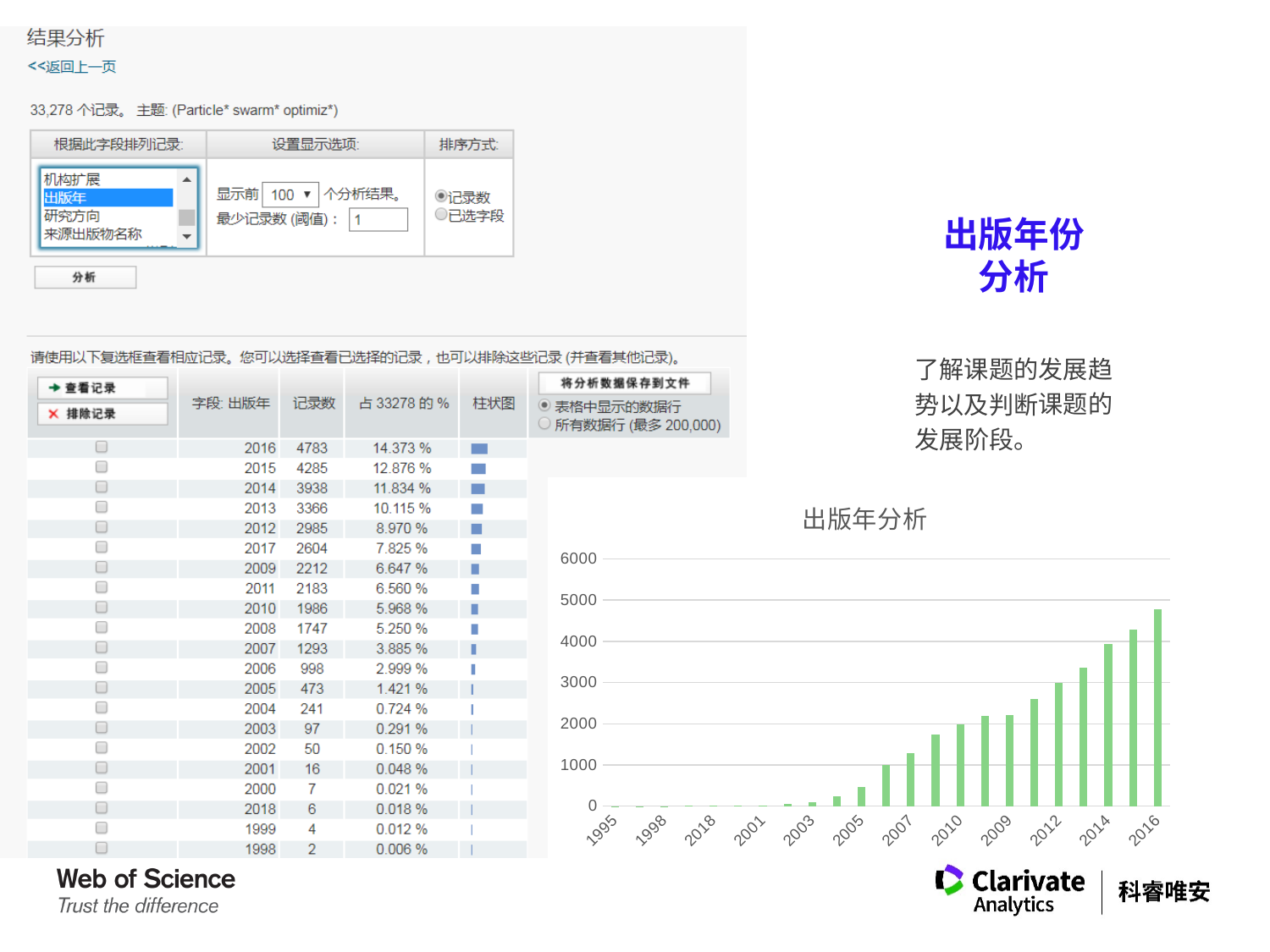
In the 出版年分析 chart, is the value for 2016 greater or less than 4000? greater In the 出版年分析 chart, is the value for 2005 greater or less than 1000? less In the 出版年分析 chart, is the value for 2014 greater or less than 3000? greater In the 出版年分析 chart, which year has the tallest bar? 2016 What kind of chart is shown under the title 出版年分析? bar chart In the 出版年分析 chart, which bar is taller, 2007 or 2005? 2007 In the 出版年分析 chart, which bar is taller, 2014 or 2012? 2014 What colour are the bars in the 出版年分析 chart? green In the 出版年分析 chart, do the bar heights rise or fall from left to right along the x axis? rise